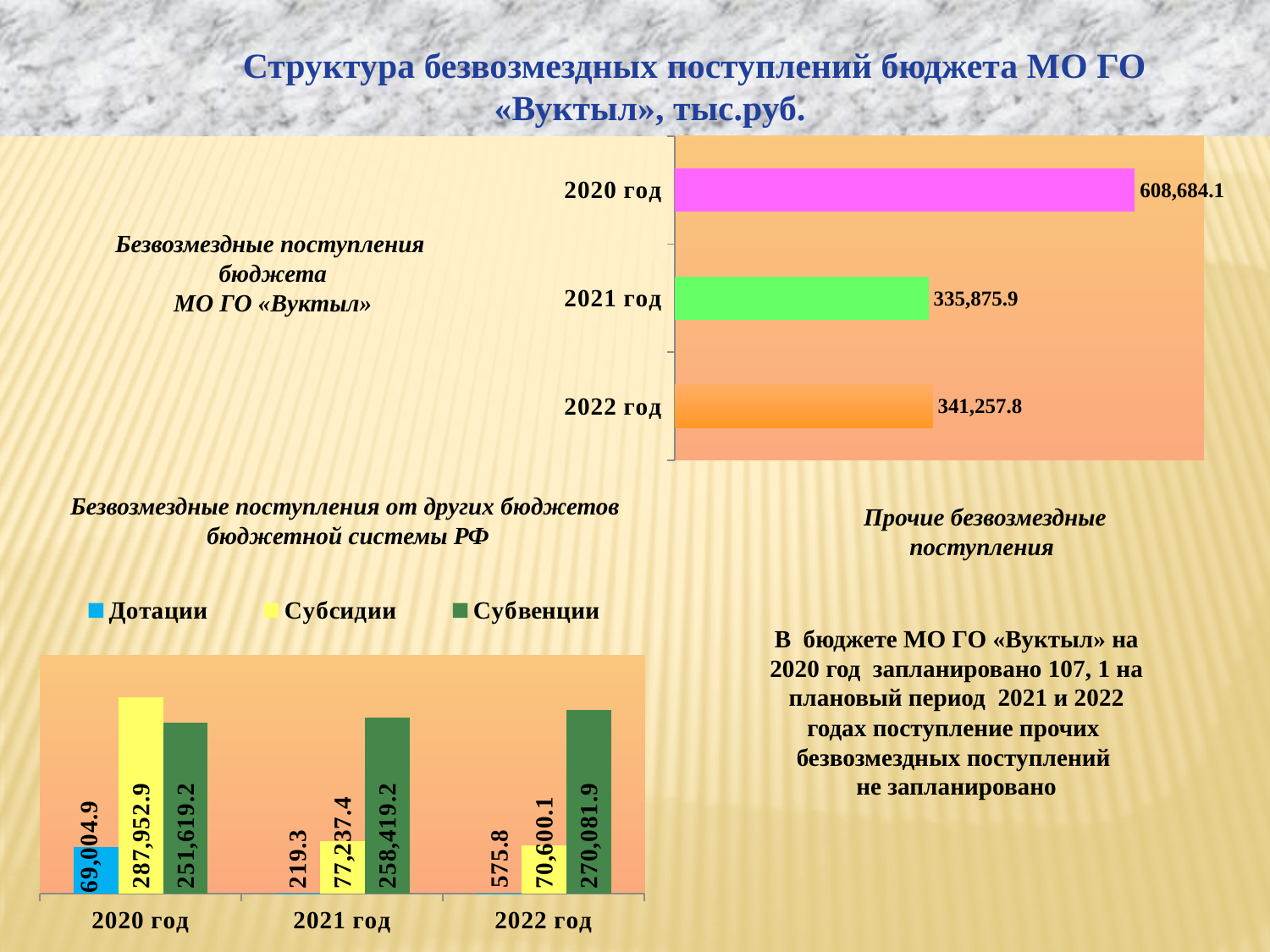
In the bottom-left chart (Безвозмездные поступления от других бюджетов бюджетной системы РФ), what is the value of Дотации for 2021 год? 219.3 In the top-right chart (Безвозмездные поступления бюджета МО ГО «Вуктыл»), which year has the highest value? 2020 год In the bottom-left chart (Безвозмездные поступления от других бюджетов бюджетной системы РФ), what is the value of Субвенции for 2022 год? 270,081.9 In the bottom-left chart (Безвозмездные поступления от других бюджетов бюджетной системы РФ), which is larger for 2020 год: Субсидии or Субвенции? Субсидии In the bottom-left chart (Безвозмездные поступления от других бюджетов бюджетной системы РФ), what is the difference between Субвенции for 2022 год and 2021 год? 11,662.7 In the top-right chart (Безвозмездные поступления бюджета МО ГО «Вуктыл»), which year has the lowest value? 2021 год What type of chart is the top-right chart (Безвозмездные поступления бюджета МО ГО «Вуктыл»)? Bar chart In the top-right chart (Безвозмездные поступления бюджета МО ГО «Вуктыл»), what is the value for 2022 год? 341,257.8 In the top-right chart (Безвозмездные поступления бюджета МО ГО «Вуктыл»), what is the difference between the values for 2020 год and 2021 год? 272,808.2 In the bottom-left chart (Безвозмездные поступления от других бюджетов бюджетной системы РФ), what is the value of Субсидии for 2020 год? 287,952.9 In the top-right chart (Безвозмездные поступления бюджета МО ГО «Вуктыл»), what is the value for 2020 год? 608,684.1 How many series does the legend of the bottom-left chart (Безвозмездные поступления от других бюджетов бюджетной системы РФ) list? 3